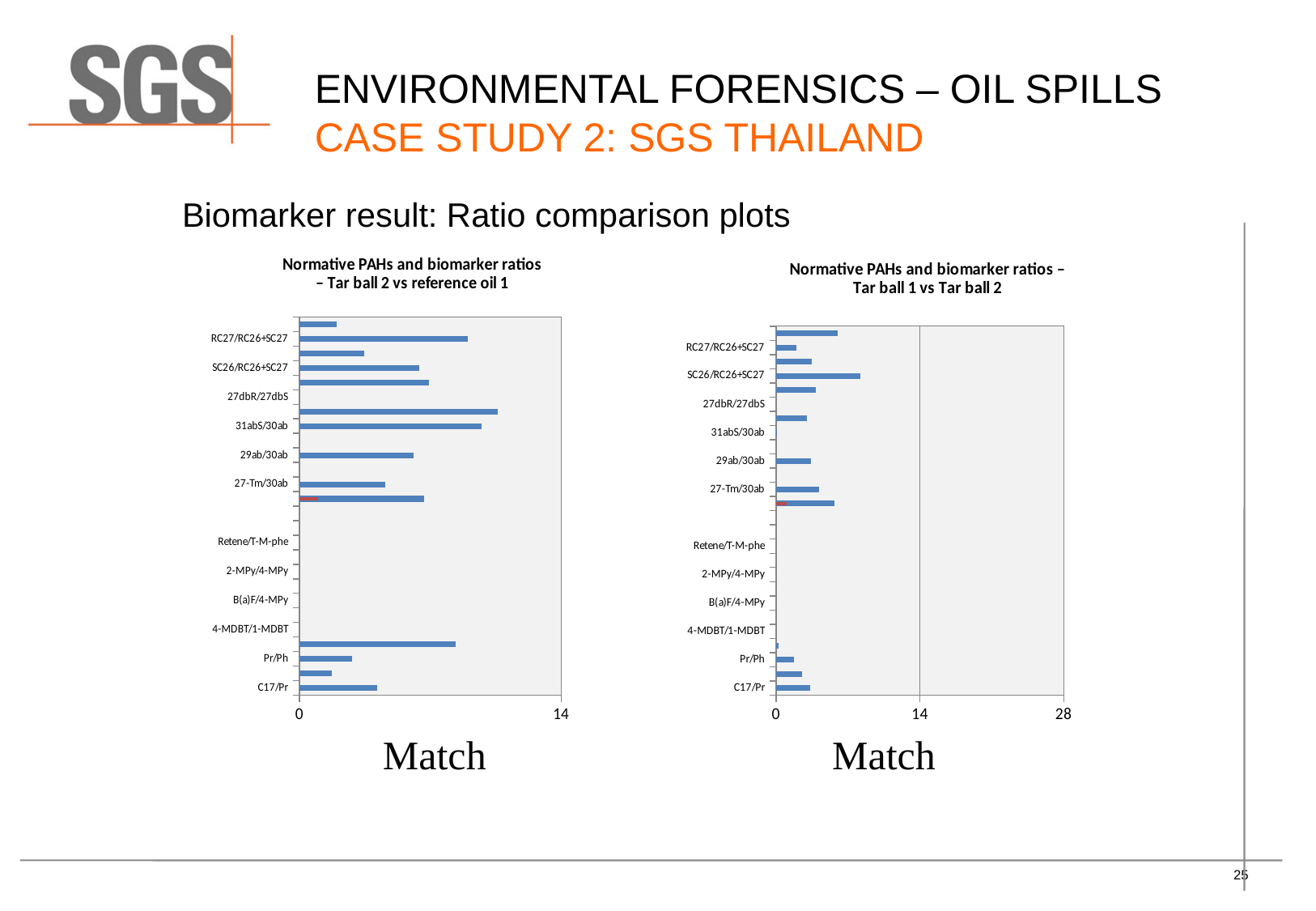
On the left chart, 'Tar ball 2 vs reference oil 1', what is the label on the horizontal axis? Match On the left chart, 'Tar ball 2 vs reference oil 1', is the value for 4-MDBT/1-MDBT greater or less than 14? less On the left chart, 'Tar ball 2 vs reference oil 1', is the value for 31abS/30ab greater or less than 14? less How many category labels are listed on the vertical axis of the right chart, 'Tar ball 1 vs Tar ball 2'? 12 On the left chart, 'Tar ball 2 vs reference oil 1', which is larger, the value for C17/Pr or the value for Retene/T-M-phe? C17/Pr How many category labels are listed on the vertical axis of the left chart, 'Tar ball 2 vs reference oil 1'? 12 On the right chart, 'Tar ball 1 vs Tar ball 2', what is the highest value shown on the horizontal axis? 28 What kind of chart is the right chart, 'Tar ball 1 vs Tar ball 2'? bar chart On the right chart, 'Tar ball 1 vs Tar ball 2', which is larger, the value for SC26/RC26+SC27 or the value for 2-MPy/4-MPy? SC26/RC26+SC27 On the right chart, 'Tar ball 1 vs Tar ball 2', is the value for C17/Pr greater or less than 14? less What kind of chart is the left chart, 'Tar ball 2 vs reference oil 1'? bar chart